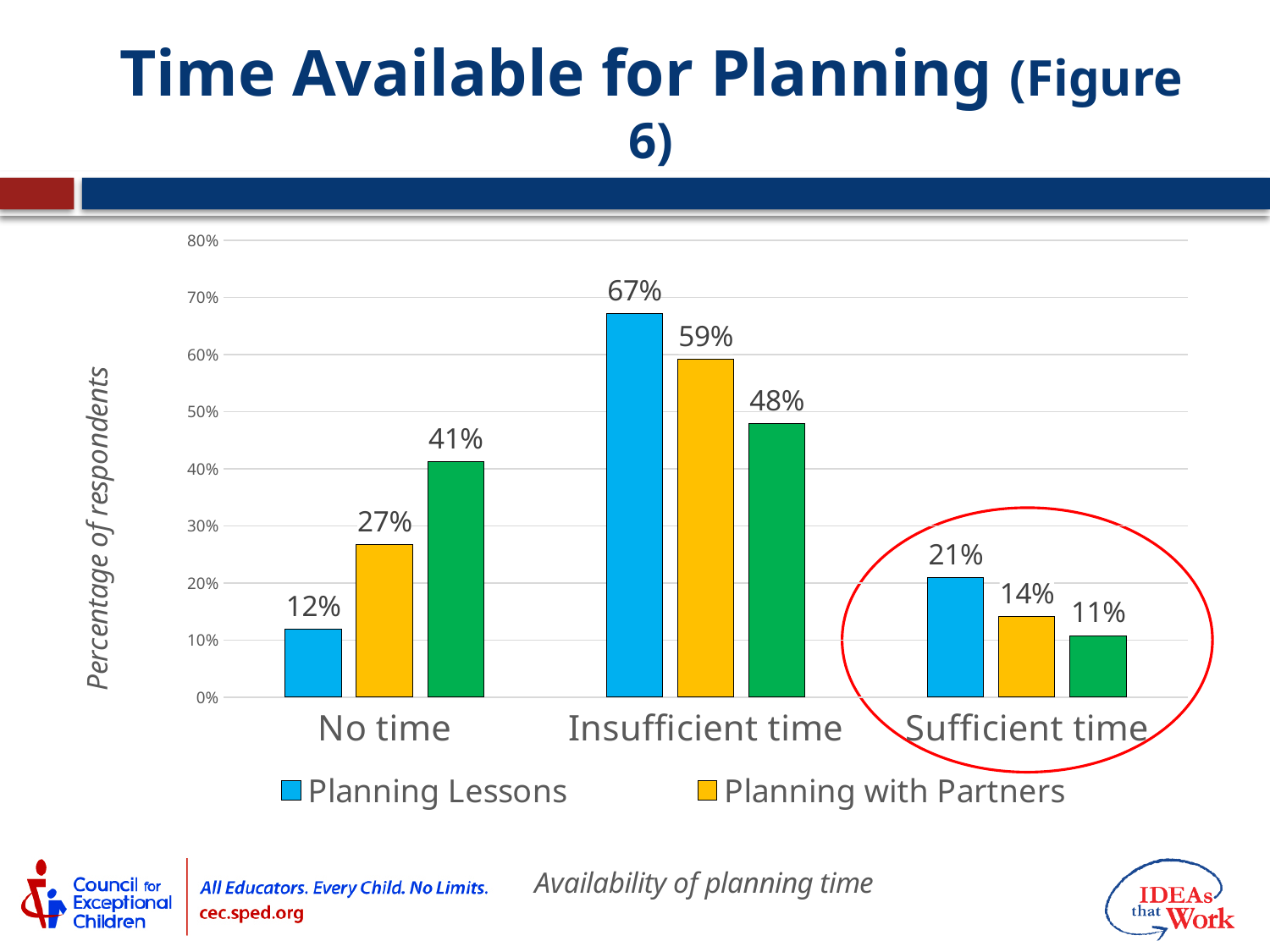
In the No time category, which is larger: Planning Lessons or Planning with Partners? Planning with Partners What is the difference between Planning Lessons and Planning with Partners in the Insufficient time category? 8 percentage points How many categories are shown on the x axis? 3 What is the value for Planning Lessons in the Sufficient time category? 21% Which category has the highest value for Planning Lessons? Insufficient time What is the value for Planning Lessons in the No time category? 12% What is the title of the vertical axis? Percentage of respondents Which category has the lowest value for Planning with Partners? Sufficient time What is the value for Planning with Partners in the Insufficient time category? 59% What kind of chart is shown on the slide? bar chart What is the value for Planning with Partners in the No time category? 27% Is the value for Planning Lessons in the Insufficient time category greater or less than 60%? greater